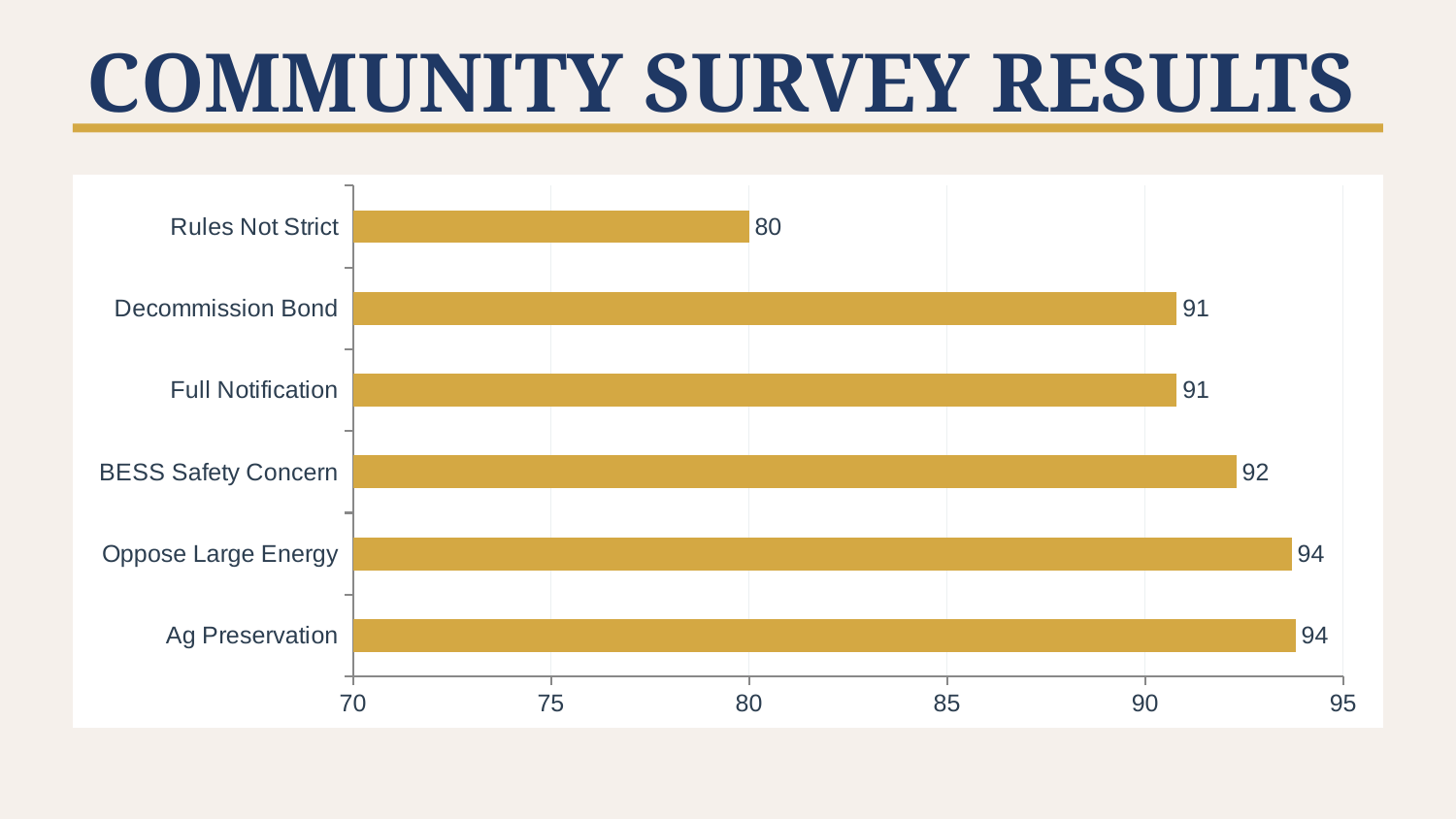
Which category has the lowest value? Rules Not Strict What is the value for BESS Safety Concern? 92 Is the value for Rules Not Strict greater or less than 85? less Which is larger, the value for BESS Safety Concern or the value for Rules Not Strict? BESS Safety Concern What is the value for Decommission Bond? 91 What kind of chart is shown on the slide? bar chart How many categories are shown in the chart? 6 What is the difference between the values for Oppose Large Energy and Rules Not Strict? 14 What is the title of the slide containing the chart? COMMUNITY SURVEY RESULTS What is the difference between the values for BESS Safety Concern and Full Notification? 1 What is the value for Ag Preservation? 94 What is the value for Rules Not Strict? 80